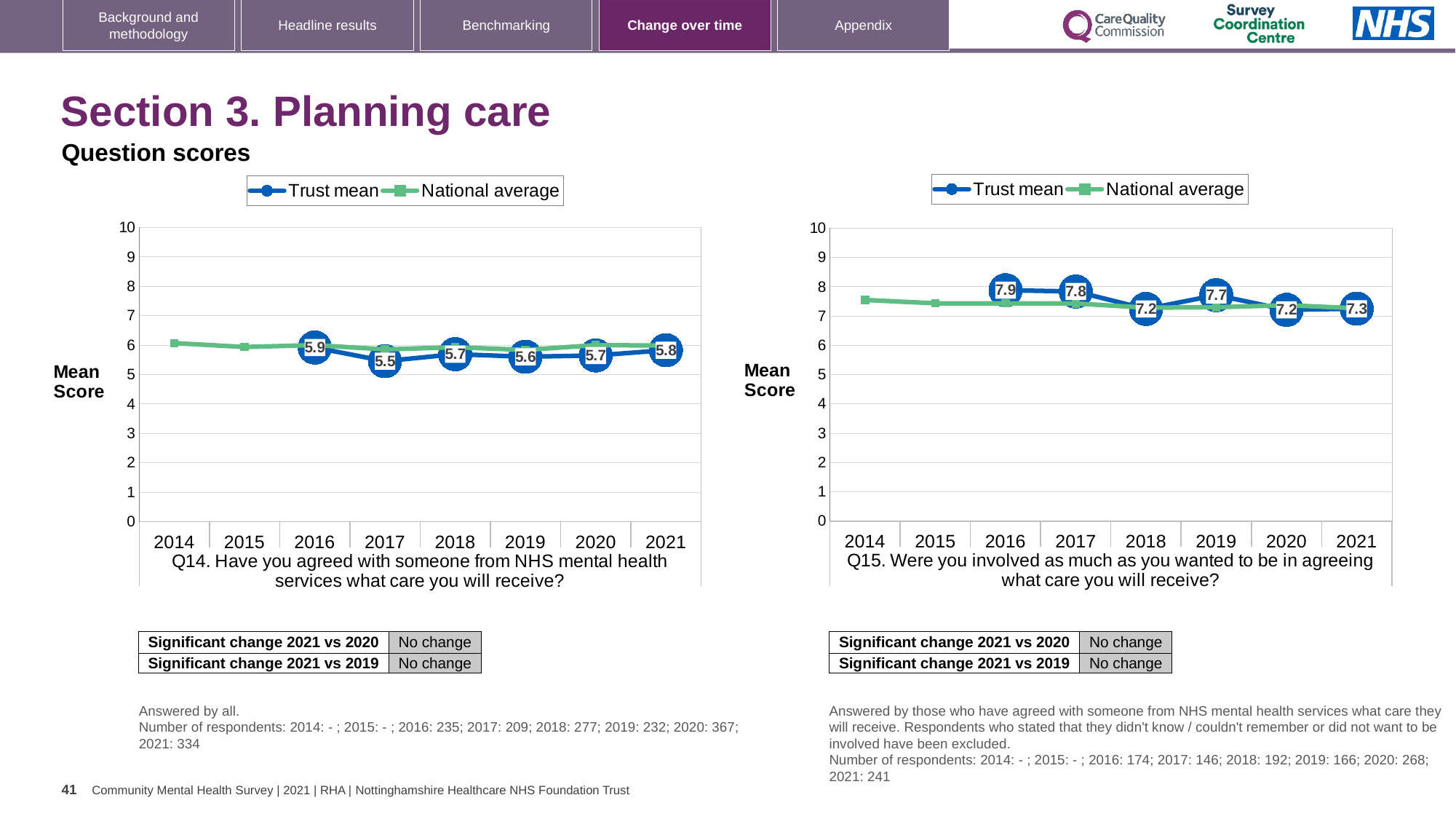
In the Q15 chart, did the Trust mean rise or fall from 2016 to 2018? Fall How many years are shown on the x axis of the Q15 chart? 8 In the Q14 chart, what is the Trust mean score for 2021? 5.8 What does the table below the Q15 chart say about the significant change 2021 vs 2020? No change In the Q15 chart, what is the Trust mean score for 2018? 7.2 In the Q14 chart, is the National average for 2014 greater or less than 5? greater In the Q15 chart, what is the difference between the Trust mean scores for 2016 and 2021? 0.6 In the Q14 chart, is the Trust mean score for 2016 or 2019 higher? 2016 In the Q14 chart, which year has the lowest labelled Trust mean score? 2017 What type of chart is used for Q14? Line chart How many series does the legend of the Q14 chart list? 2 In the Q15 chart, which year has the highest labelled Trust mean score? 2016